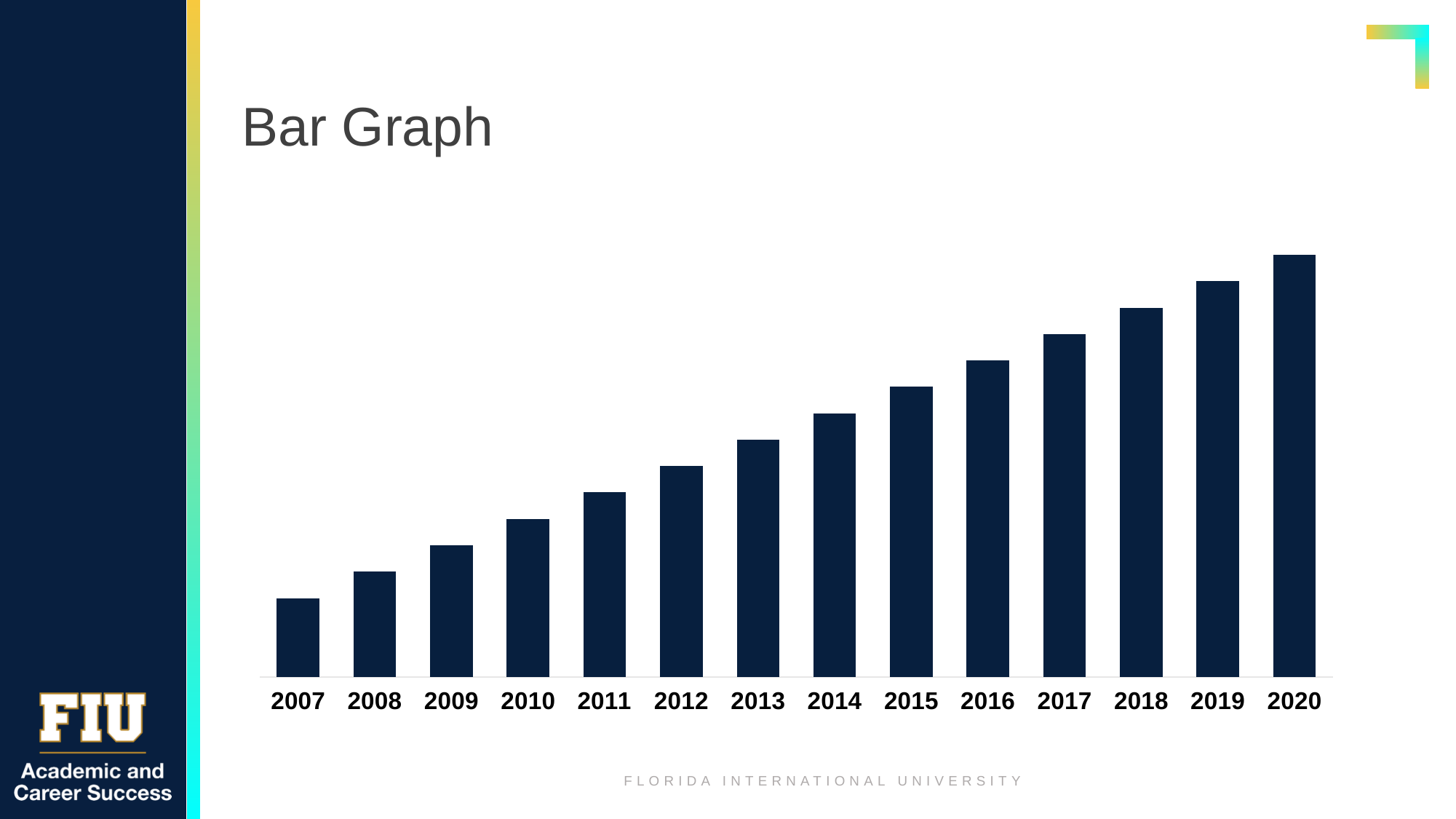
What kind of chart is shown on the slide? bar chart What is the title of the slide containing the chart? Bar Graph Which year has the larger value, 2012 or 2018? 2018 Which year has the larger value, 2015 or 2010? 2015 Do the bar values rise or fall from 2007 to 2020? rise How many years are shown on the x axis of the chart? 14 Which year has the lowest bar in the chart? 2007 What is the first year shown on the x axis? 2007 Which year has the larger value, 2009 or 2008? 2009 Which year has the highest bar in the chart? 2020